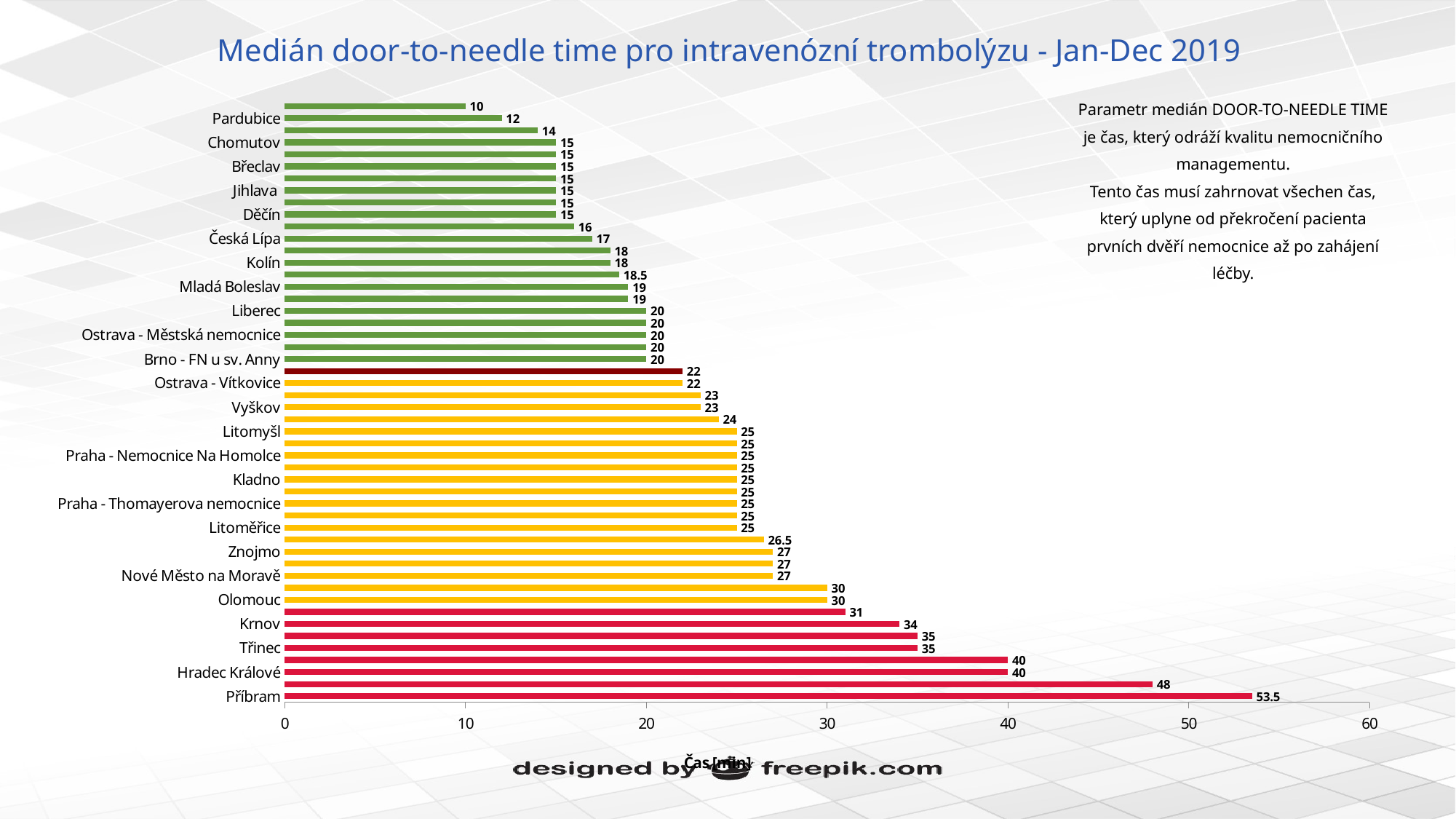
Which labelled hospital has the highest median door-to-needle time? Příbram What is the label of the horizontal axis? Čas [min] Which has a larger median door-to-needle time, Třinec or Krnov? Třinec What is the median door-to-needle time for Olomouc? 30 What is the title of the chart? Medián door-to-needle time pro intravenózní trombolýzu - Jan-Dec 2019 Is the median door-to-needle time for Příbram greater or less than 50? greater What is the difference between the median door-to-needle times of Příbram and Hradec Králové? 13.5 What is the median door-to-needle time for Krnov? 34 What kind of chart is shown on the slide? bar chart What is the median door-to-needle time for Hradec Králové? 40 What is the median door-to-needle time for Pardubice? 12 What is the median door-to-needle time for Příbram? 53.5